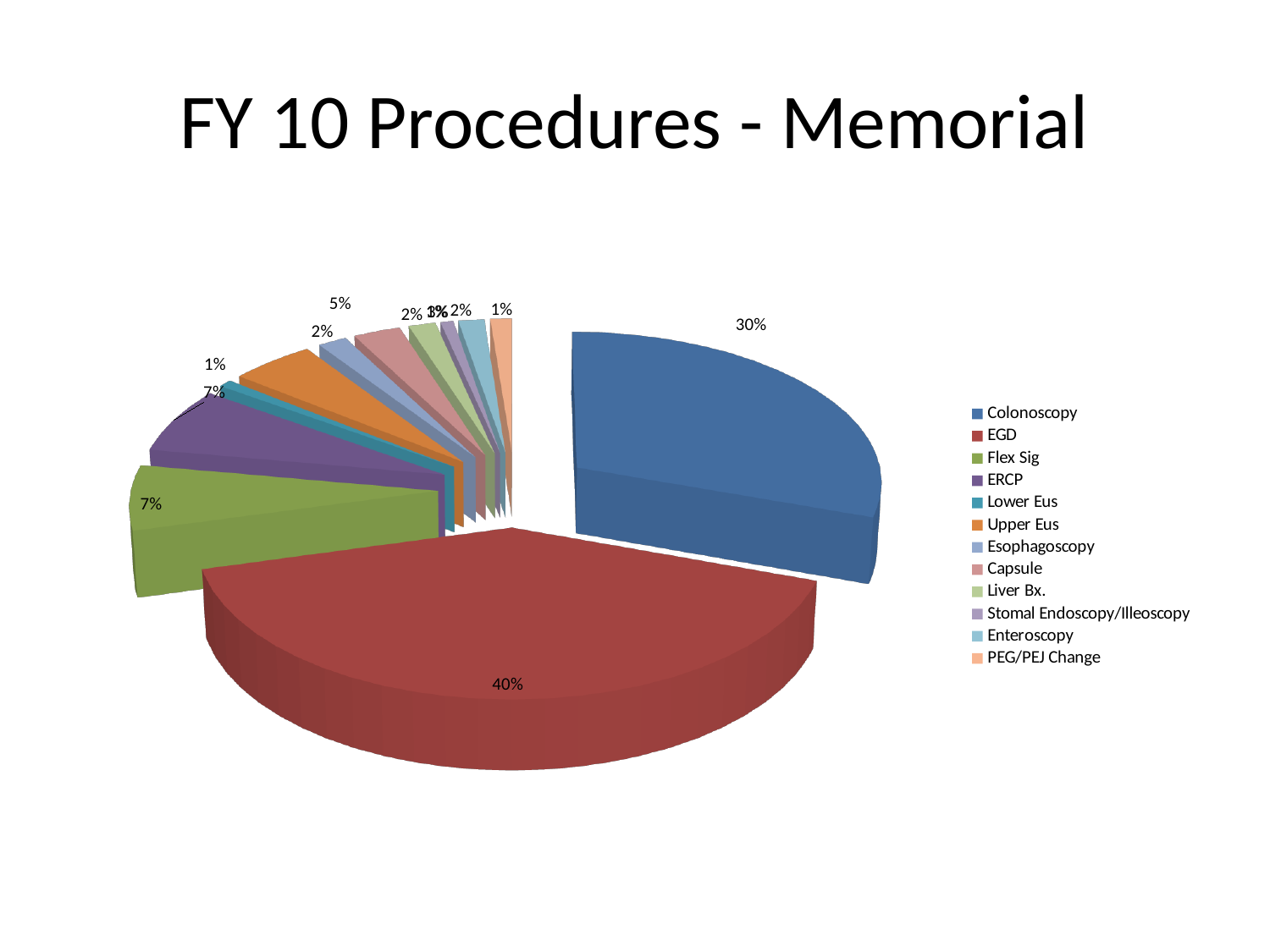
How many categories does the legend list? 12 What is the difference in percentage points between the EGD share and the Colonoscopy share? 10 Which procedure has the largest share of the pie? EGD Which is larger, the share for Colonoscopy or the share for EGD? EGD What type of chart is shown on the slide? Pie chart What is the combined share of EGD and Colonoscopy? 70% What share of the pie does EGD represent? 40% What share of the pie does Upper Eus represent? 5% What is the title of the chart? FY 10 Procedures - Memorial Which legend entry is listed last? PEG/PEJ Change What share of the pie does Flex Sig represent? 7%